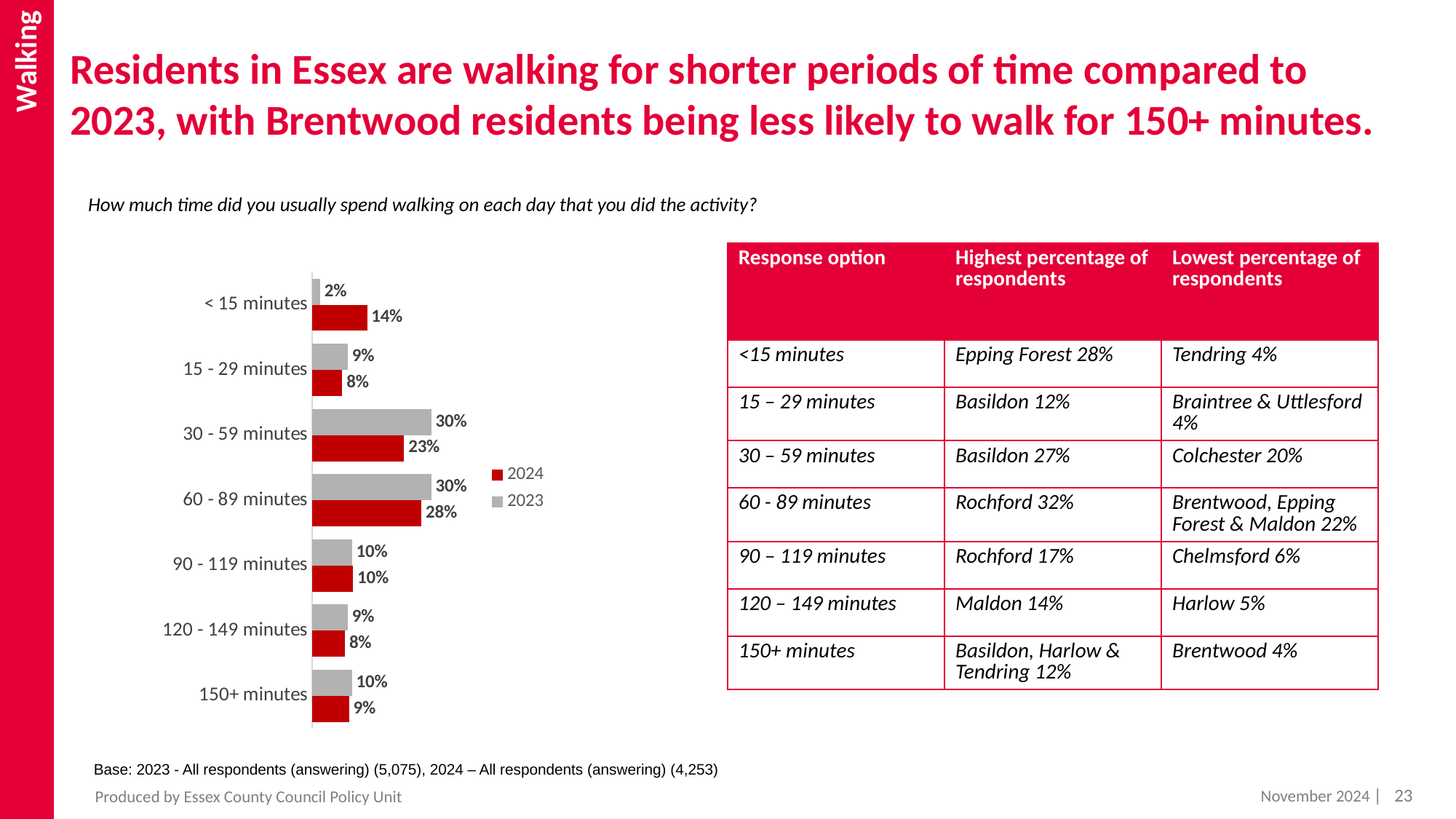
What is the difference between the 2023 and 2024 values for 30 - 59 minutes? 7 percentage points What is the difference between the 2024 and 2023 values for < 15 minutes? 12 percentage points Which colour represents the 2024 series in the chart? Red Which time category has the highest 2024 value? 60 - 89 minutes What percentage of respondents in 2024 walked for 60 - 89 minutes? 28% For 150+ minutes, which year has the larger value, 2023 or 2024? 2023 What was the 2023 value for 30 - 59 minutes? 30% Which time category has the lowest 2023 value? < 15 minutes What percentage of respondents in 2024 walked for less than 15 minutes? 14% How many series does the chart legend list? 2 What type of chart is shown on the slide? Bar chart How many time categories are shown in the chart? 7